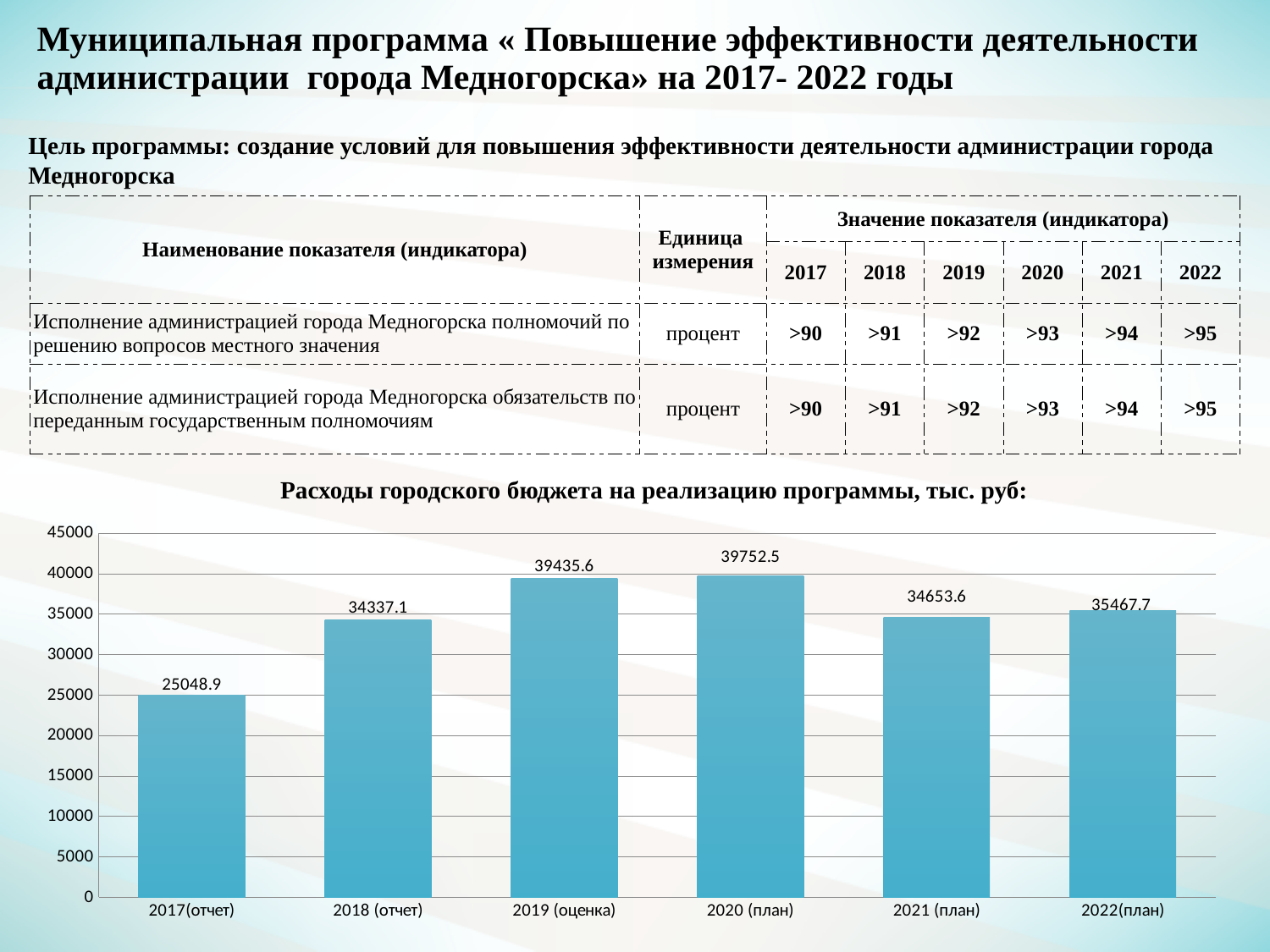
What is the title of the chart? Расходы городского бюджета на реализацию программы, тыс. руб: What is the value for 2020 (план) in the bar chart? 39752.5 Is the value for 2018 (отчет) greater or less than 30000? greater What is the difference between the values for 2022(план) and 2021 (план)? 814.1 What kind of chart is shown on the slide? bar chart Which is larger, the value for 2021 (план) or the value for 2022(план)? 2022(план) What is the value for 2022(план) in the bar chart? 35467.7 How many categories are shown in the bar chart? 6 What is the difference between the values for 2020 (план) and 2017(отчет)? 14703.6 What is the value for 2017(отчет) in the bar chart? 25048.9 Which category has the highest value in the bar chart? 2020 (план) Which category has the lowest value in the bar chart? 2017(отчет)